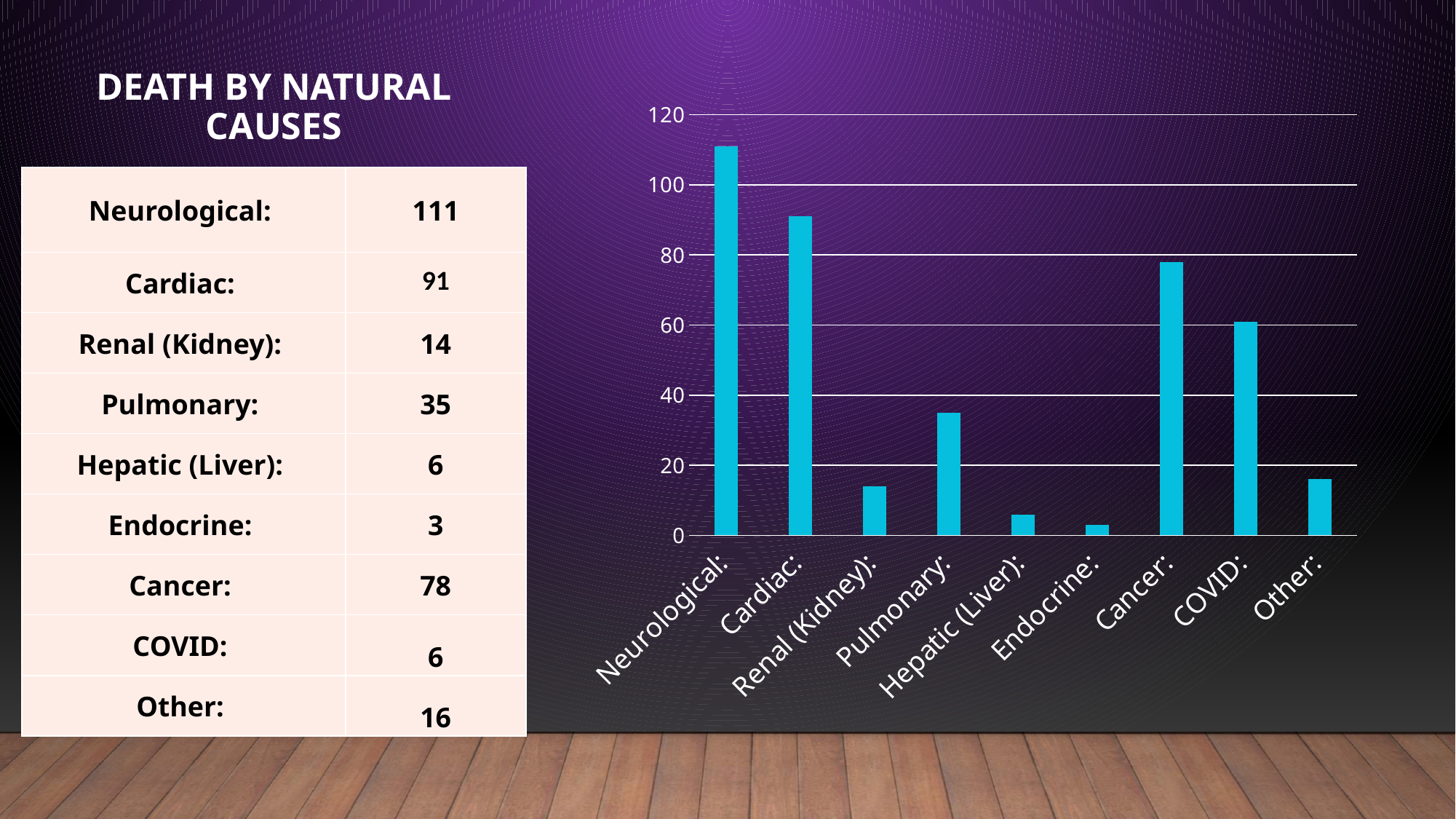
How many categories are shown on the x axis of the bar chart? 9 What is the value for Pulmonary in the bar chart? 35 What is the value for Cardiac in the bar chart? 91 Is the value for COVID in the bar chart greater or less than 40? greater Which is larger, the value for Cancer or the value for Pulmonary? Cancer Which category has the lowest bar in the chart? Endocrine Is the value for Renal (Kidney) greater or less than 20? less What is the difference between the Neurological and Cardiac values? 20 What is the title of the slide containing the chart? Death by Natural Causes What is the value for Neurological in the bar chart? 111 Which category has the highest bar in the chart? Neurological What kind of chart is shown on the slide? bar chart